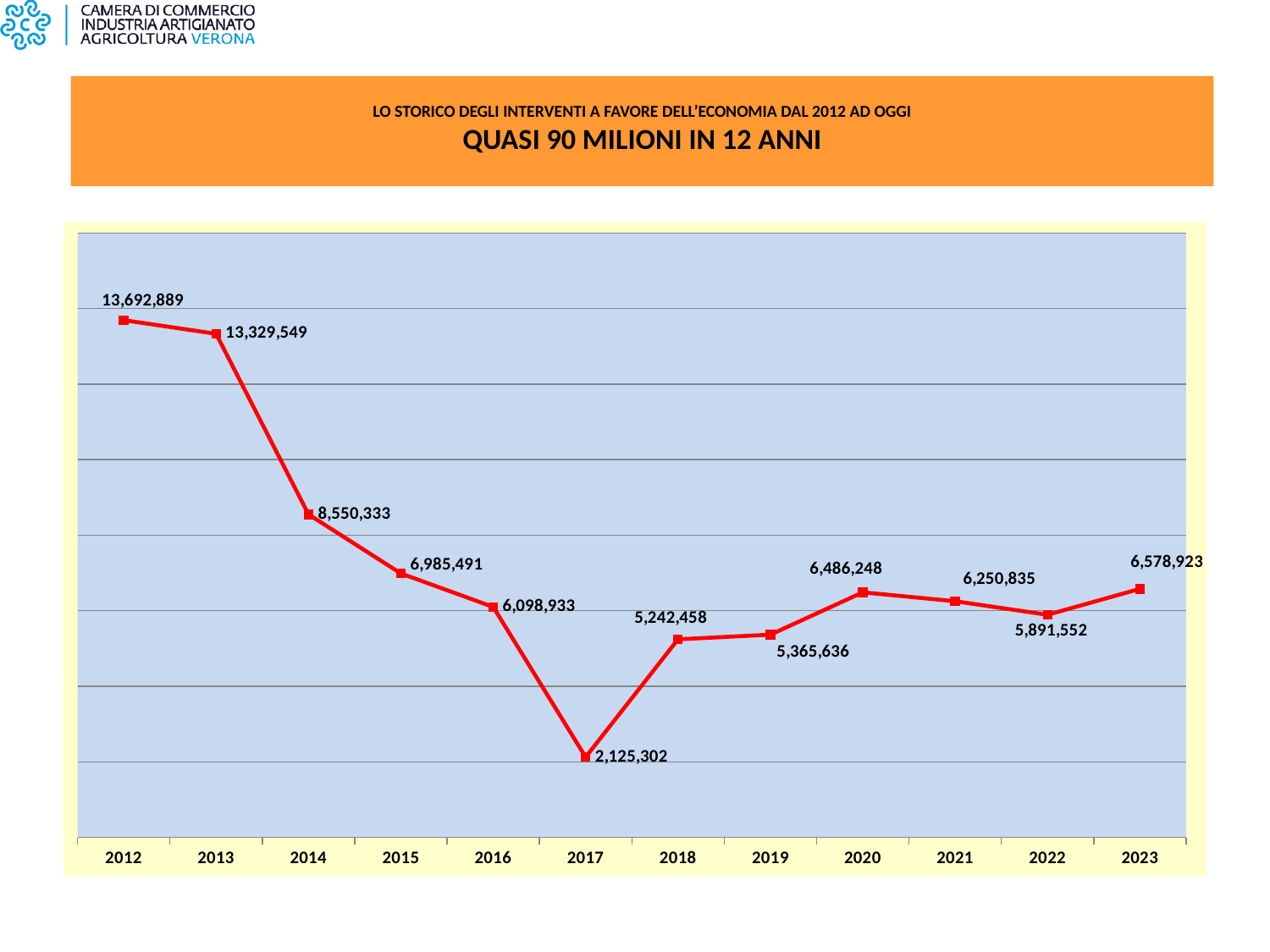
Which year has the highest value? 2012 What is the value for 2023? 6,578,923 What kind of chart is shown on the slide? line chart What is the value for 2020? 6,486,248 What is the value for 2012? 13,692,889 What is the difference between the values for 2023 and 2022? 687,371 Which is larger, the value for 2020 or the value for 2021? 2020 Which year has the lowest value? 2017 What is the difference between the values for 2012 and 2013? 363,340 What is the value for 2017? 2,125,302 How many years are plotted on the chart? 12 Do the values rise or fall from 2012 to 2017? fall